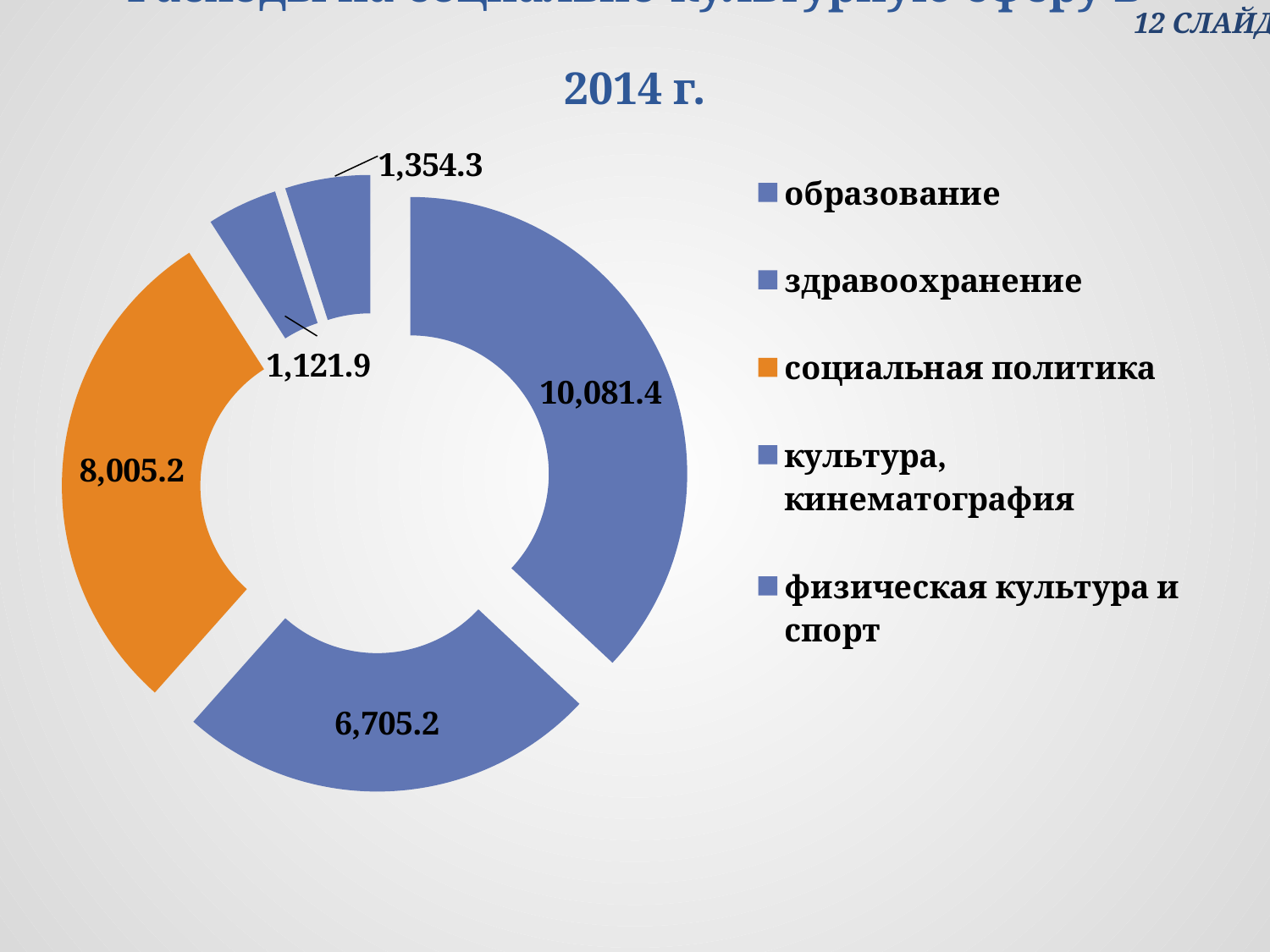
What is the value for социальная политика? 8,005.2 What is the value for физическая культура и спорт? 1,354.3 What is the difference between the values for образование and социальная политика? 2,076.2 What is the difference between the values for социальная политика and здравоохранение? 1,300.0 Which category has the smallest value? культура, кинематография How many categories does the chart show? 5 Which category has the largest value? образование What kind of chart is shown on the slide? Doughnut (pie) chart What is the value for образование? 10,081.4 Which category is shown in orange? социальная политика Which is larger, the value for социальная политика or the value for здравоохранение? социальная политика What is the value for здравоохранение? 6,705.2